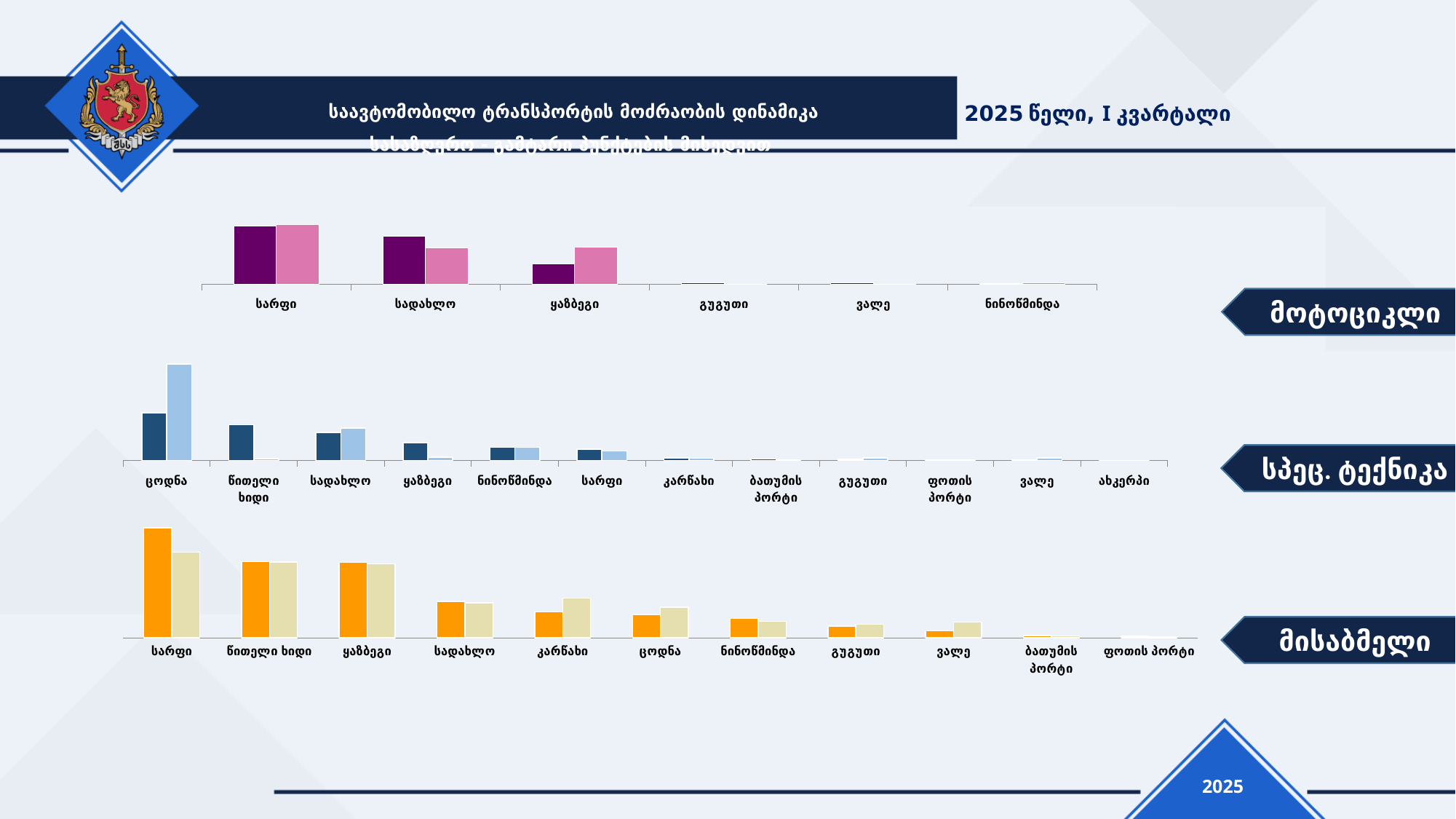
In the მისაბმელი chart, for კარწახი, is the orange bar or the beige bar taller? beige In the სპეც. ტექნიკა chart, which category has the tallest bar? ცოდნა What kind of chart is the მოტოციკლი chart at the top of the slide? bar chart How many categories are shown on the x axis of the მისაბმელი chart at the bottom of the slide? 11 How many categories are shown on the x axis of the მოტოციკლი chart? 6 In the მისაბმელი chart, which category has the tallest bar? სარფი In the მოტოციკლი chart, for ყაზბეგი, is the dark purple bar or the pink bar taller? pink How many bar charts are shown on the slide? 3 How many categories are shown on the x axis of the სპეც. ტექნიკა chart in the middle of the slide? 12 In the მოტოციკლი chart, for სადახლო, is the dark purple bar or the pink bar taller? dark purple In the მოტოციკლი chart, which category has the tallest bars? სარფი